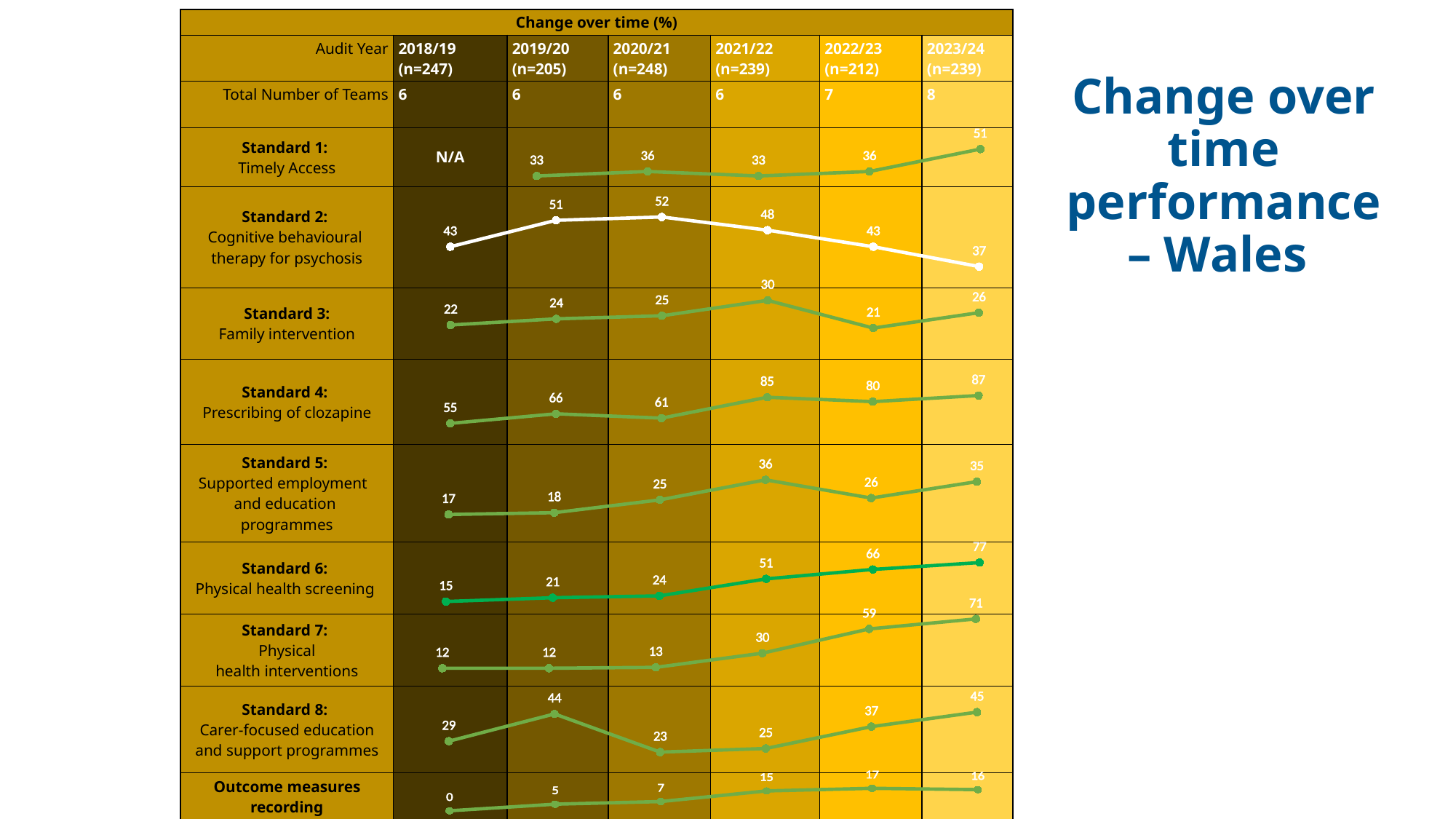
What is the difference between the 2023/24 and 2018/19 values for Standard 6: Physical health screening? 62 Does the value for Standard 2: Cognitive behavioural therapy for psychosis rise or fall from 2020/21 to 2023/24? Fall Which is larger for 2021/22: the value for Standard 4: Prescribing of clozapine or the value for Standard 6: Physical health screening? Standard 4: Prescribing of clozapine In which audit year is the value for Standard 8: Carer-focused education and support programmes lowest? 2020/21 In which audit year is the value for Standard 6: Physical health screening highest? 2023/24 What is the value for Standard 7: Physical health interventions in 2022/23? 59 What is the total number of teams in 2023/24? 8 How many audit years are plotted for each standard? 6 (Standard 1 has only 5 plotted, as 2018/19 is N/A) What is the value for Standard 4: Prescribing of clozapine in 2023/24? 87 What is the value shown for Standard 1: Timely Access in 2018/19? N/A What is the value for Standard 2: Cognitive behavioural therapy for psychosis in 2020/21? 52 What kind of chart is used to show each standard's change over time? Line chart